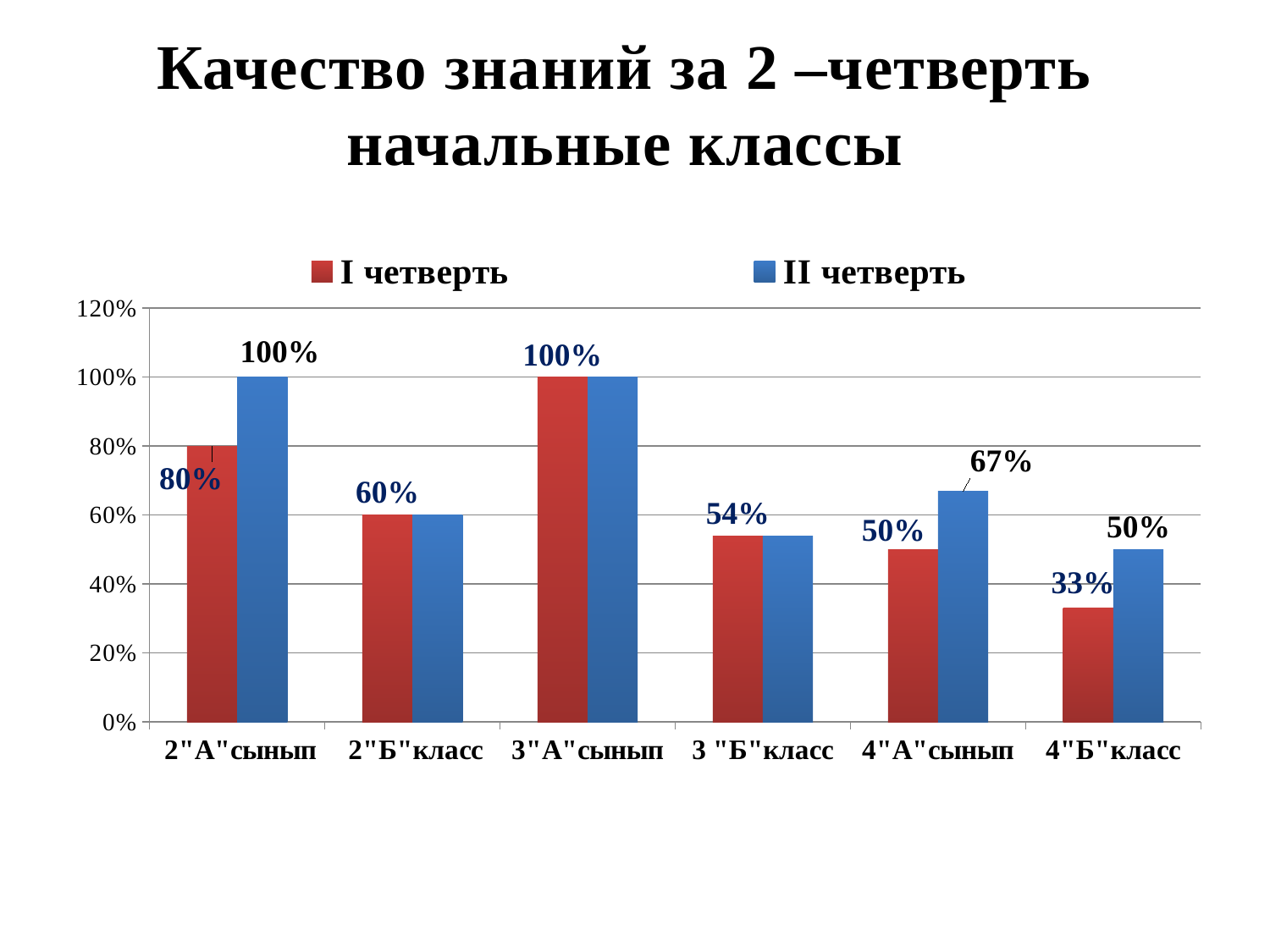
What is the value for I четверть for 4"Б"класс? 33% What kind of chart is shown on the slide? bar chart How many series does the legend list? 2 How many classes (categories) are shown on the x axis? 6 Which is larger for 4"А"сынып: the I четверть value or the II четверть value? II четверть What is the value for II четверть for 2"А"сынып? 100% What is the difference between the II четверть and I четверть values for 4"Б"класс? 17% What is the value for 3 "Б"класс? 54% Which class has the lowest I четверть value? 4"Б"класс What is the value for II четверть for 4"А"сынып? 67% Which series is shown in red in the legend? I четверть What is the value for I четверть for 2"А"сынып? 80%